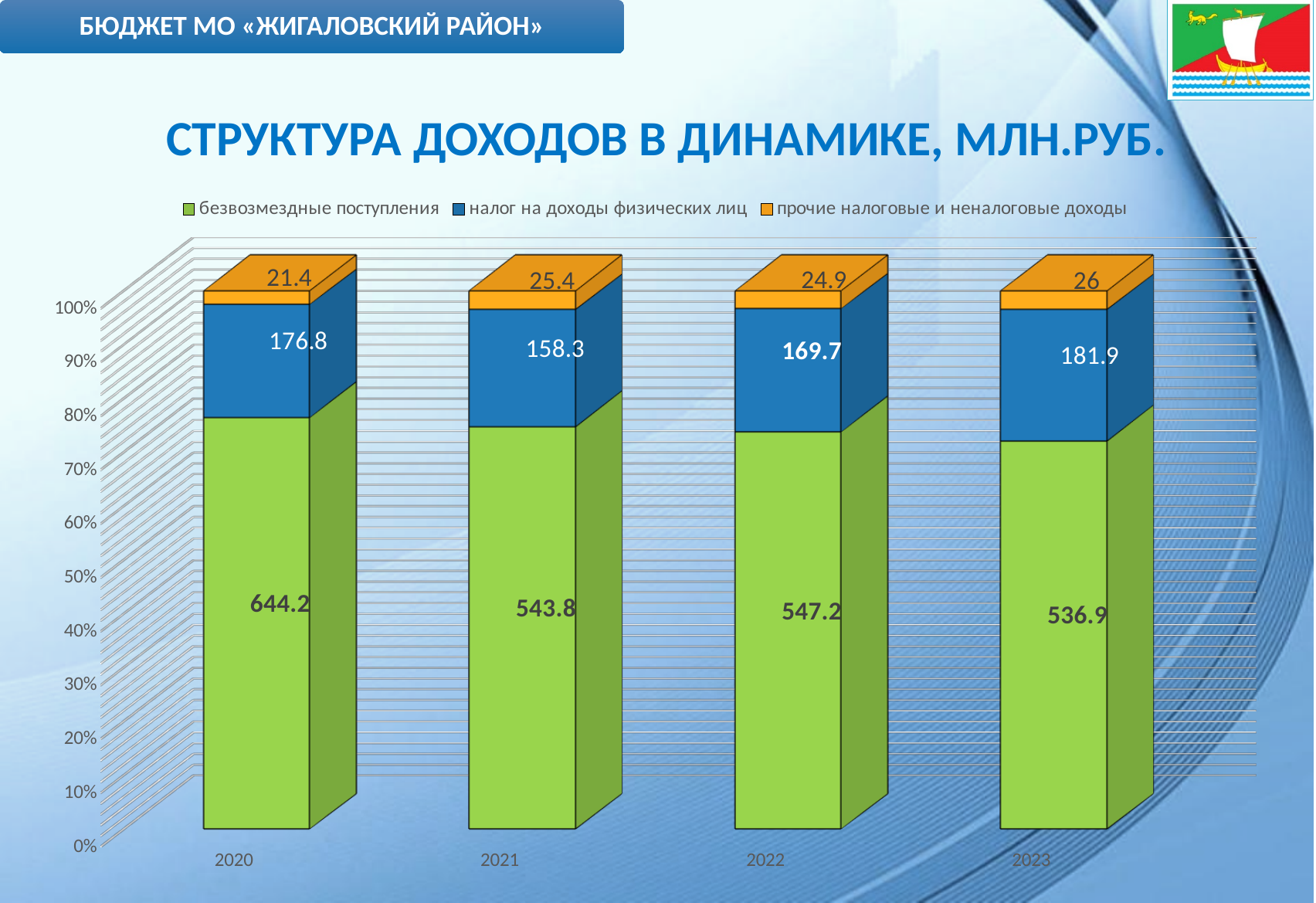
What is the total of the stacked bar for 2022? 741.8 What is the value of прочие налоговые и неналоговые доходы for 2021? 25.4 What is the title of the chart? СТРУКТУРА ДОХОДОВ В ДИНАМИКЕ, МЛН.РУБ. How many years are shown on the x axis? 4 In which year is безвозмездные поступления highest? 2020 What is the value of безвозмездные поступления for 2020? 644.2 In which year is налог на доходы физических лиц lowest? 2021 Which is larger: налог на доходы физических лиц in 2022 or in 2023? 2023 How many series does the legend list? 3 What is the value of налог на доходы физических лиц for 2023? 181.9 What kind of chart is shown on the slide? Stacked bar chart What is the difference between безвозмездные поступления in 2020 and in 2021? 100.4